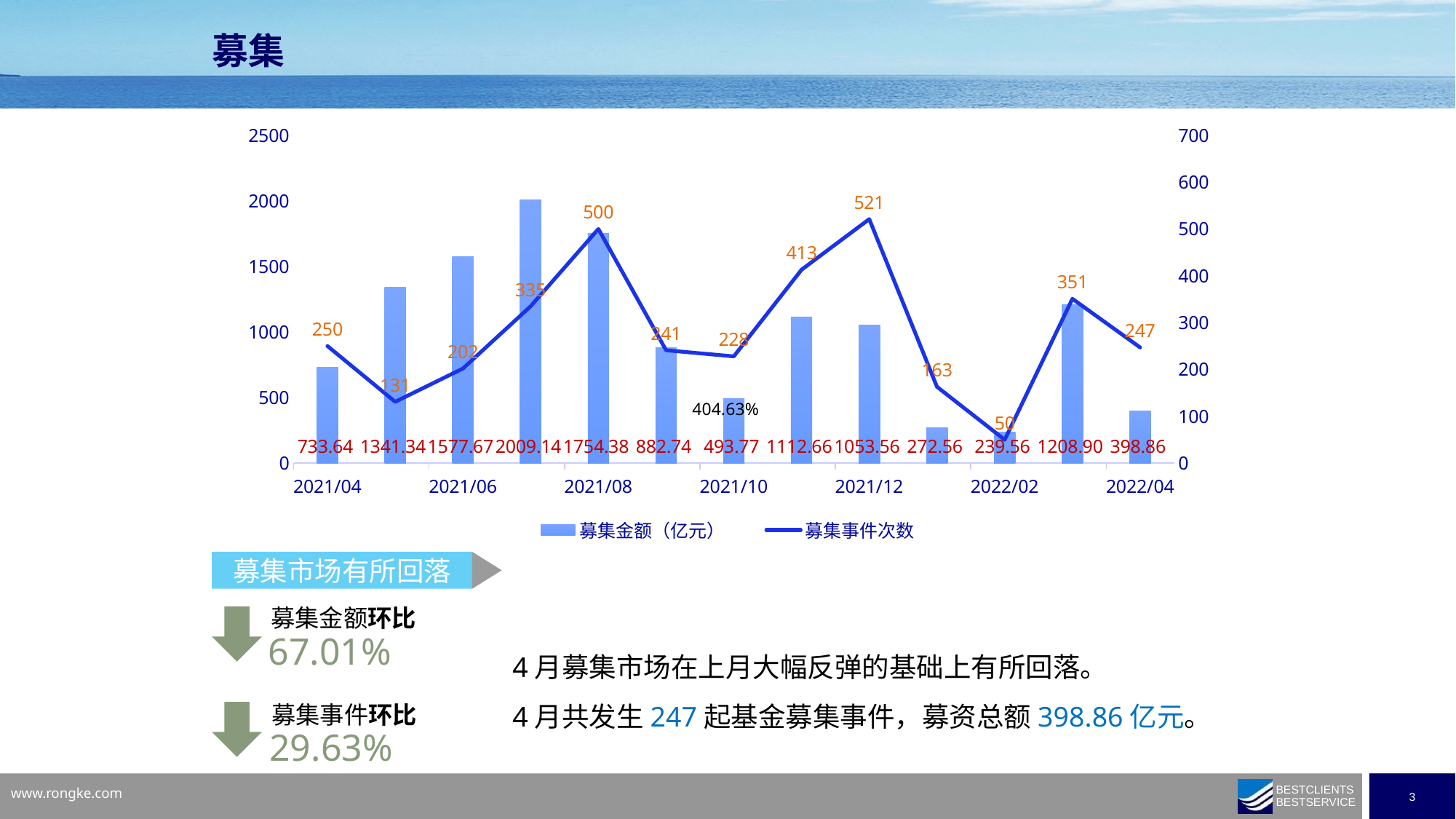
What is the 募集事件次数 value for 2021/12? 521 What is the highest 募集金额（亿元） value shown in the chart? 2009.14 Does the 募集事件次数 line rise or fall from 2021/12 to 2022/02? Fall Which month has the lowest 募集事件次数? 2022/02 What is the 募集金额（亿元） value for 2022/04? 398.86 What kind of chart is shown on the slide? Combination bar and line chart How many months are plotted in the chart? 13 How many series does the legend list? 2 What is the lowest 募集事件次数 value shown in the chart? 50 What is the 募集金额（亿元） value for 2021/10? 493.77 What is the difference between the 募集金额（亿元） values for 2022/04 and 2022/02? 159.30 Which month has the higher 募集事件次数, 2021/08 or 2021/12? 2021/12